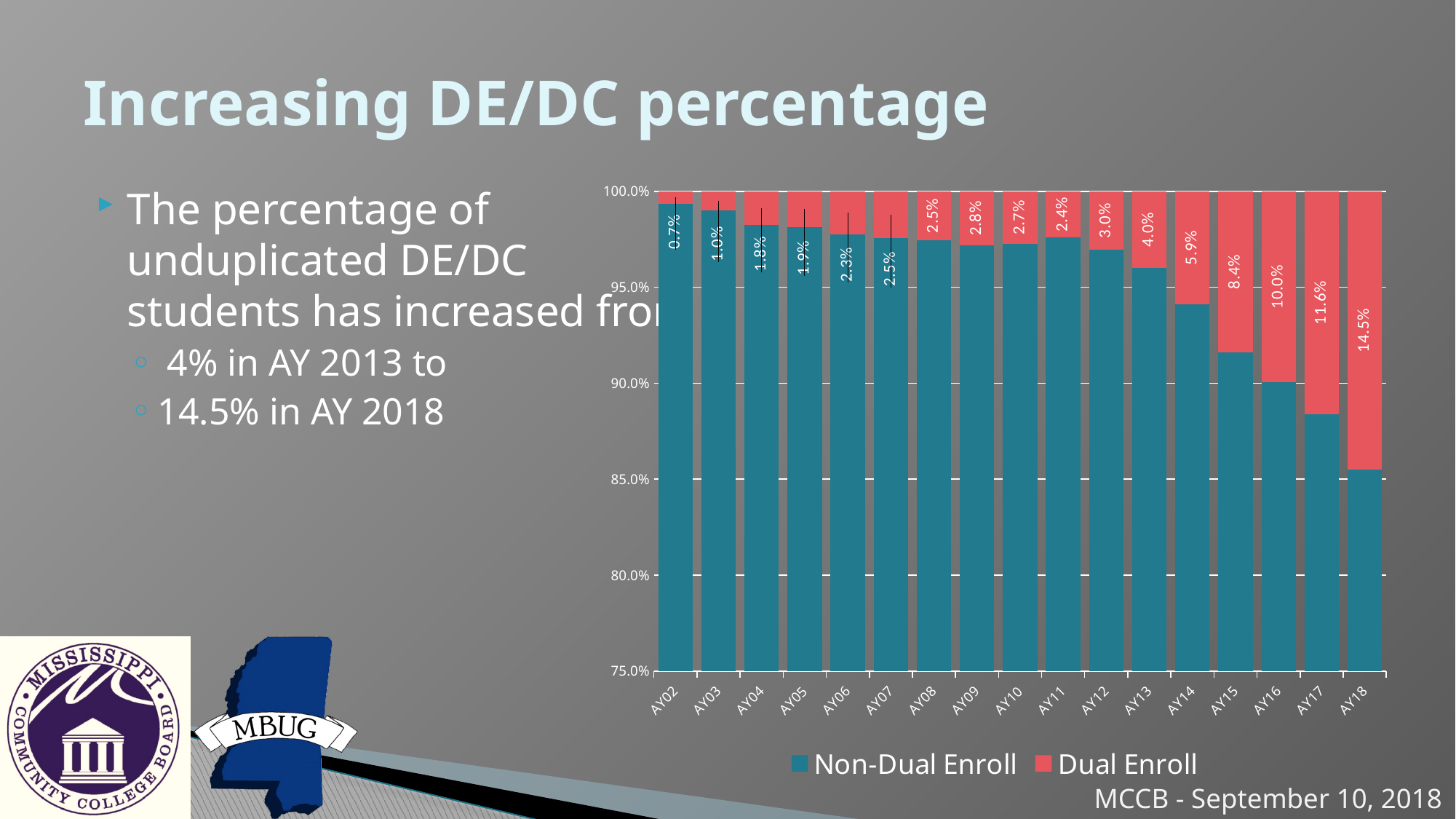
Which academic year has the highest Dual Enroll percentage? AY18 How many series does the legend list? 2 Does the Dual Enroll percentage generally rise or fall from AY02 to AY18? rise Which academic year has the lowest Dual Enroll percentage? AY02 What kind of chart is shown on the slide? stacked bar chart What is the Dual Enroll value for AY13? 4.0% Is the Non-Dual Enroll value for AY18 greater or less than 90.0%? less How many academic years are shown on the x axis? 17 Which is larger, the Dual Enroll value for AY14 or for AY12? AY14 What is the Dual Enroll value for AY06? 2.3% What is the Dual Enroll value for AY18? 14.5% What is the difference between the Dual Enroll values for AY18 and AY13? 10.5%